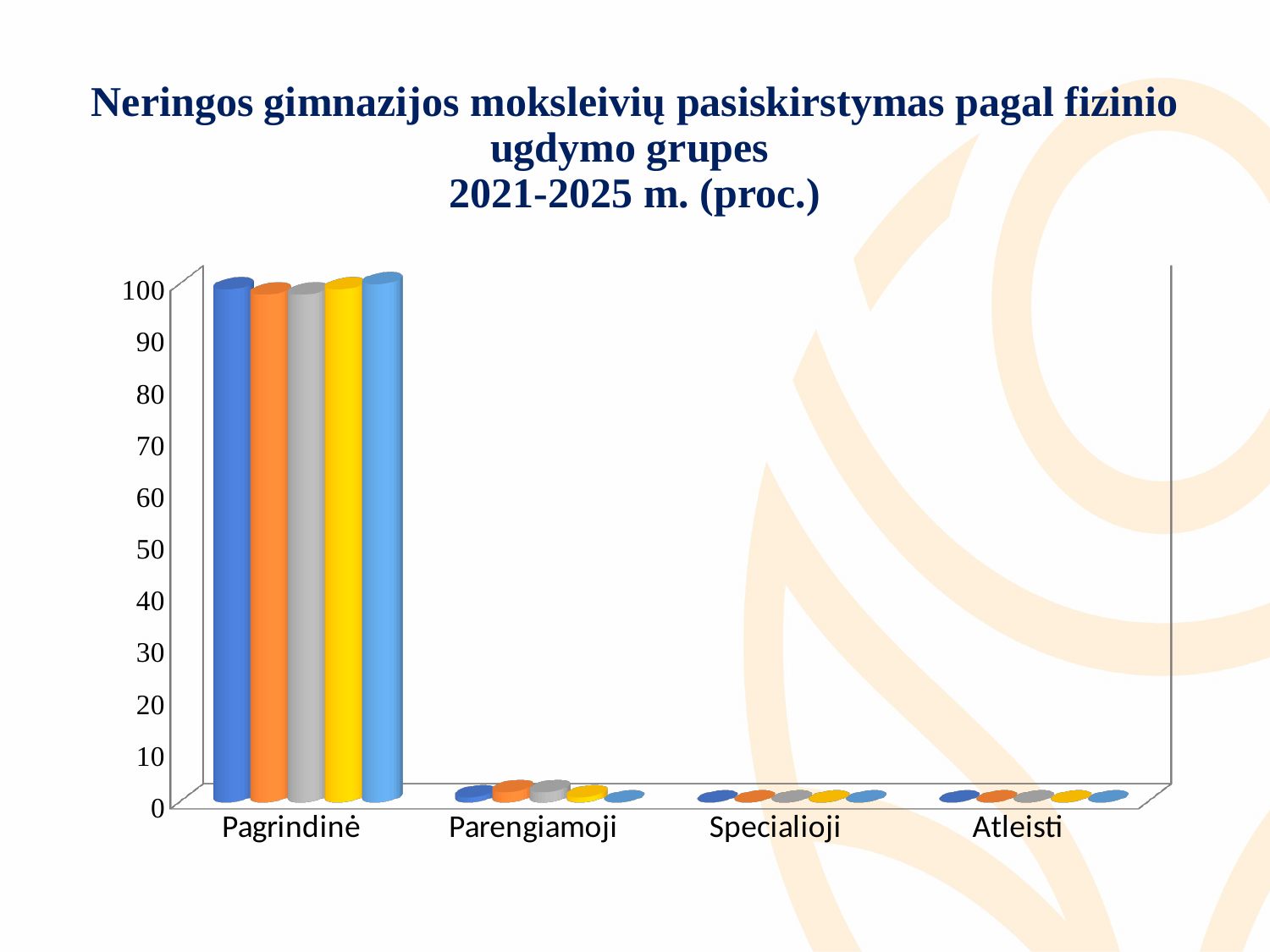
Which category has the highest values in the chart? Pagrindinė Is the value for Pagrindinė greater or less than 90? greater Is the value for Specialioji greater or less than 10? less What kind of chart is shown on the slide? bar chart Is the value for Atleisti greater or less than 20? less What period of years does the chart title say the data covers? 2021-2025 m. How many categories are shown on the x axis of the chart? 4 Which is larger, the value for Pagrindinė or the value for Parengiamoji? Pagrindinė What is the highest tick value shown on the vertical axis of the chart? 100 Which is larger, the value for Pagrindinė or the value for Atleisti? Pagrindinė